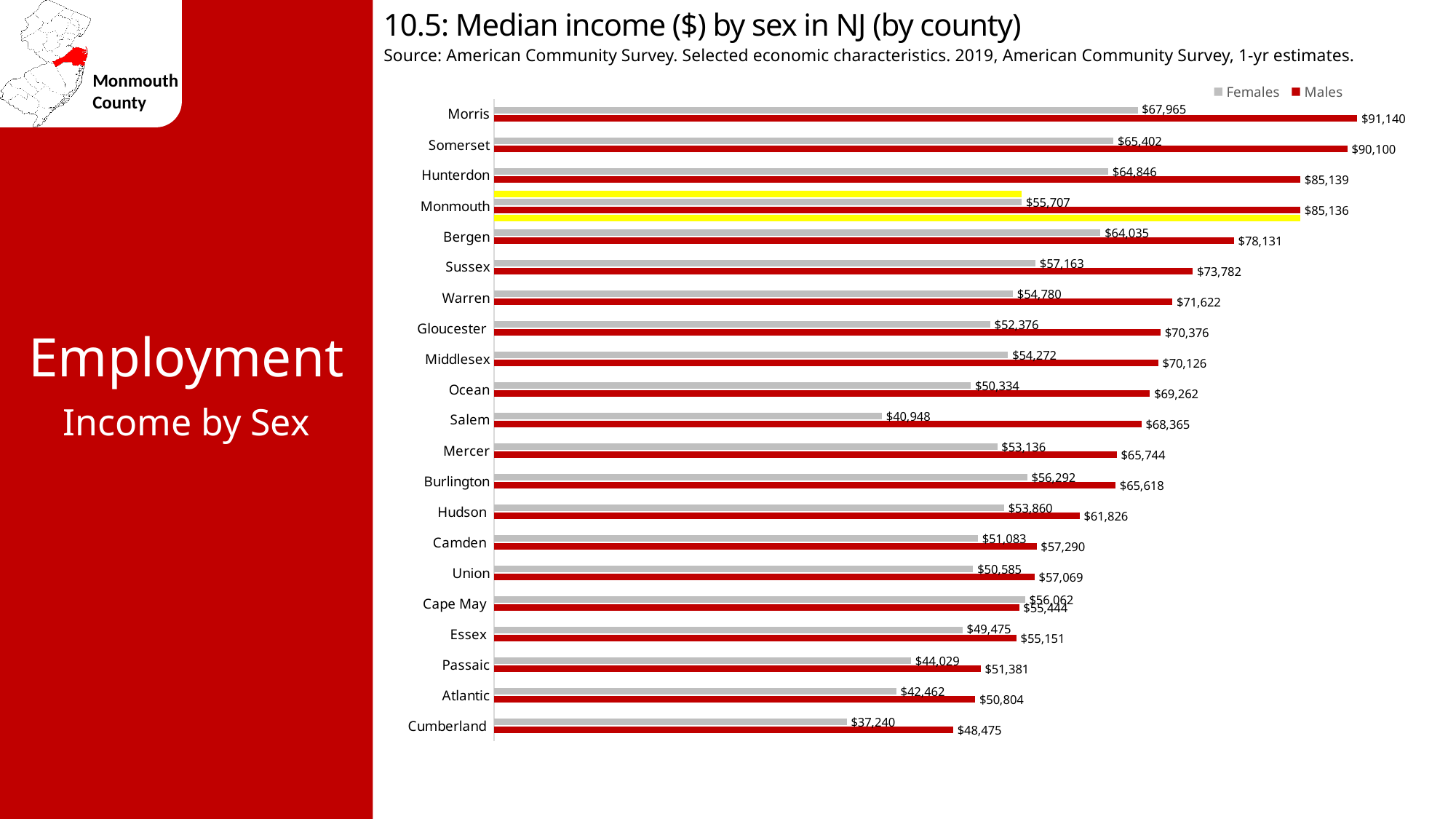
What is the median income for males in Monmouth County? $85,136 What is the median income for females in Salem County? $40,948 What is the difference between the male and female median incomes in Morris County? $23,175 How many counties are shown in the chart? 21 Which county has the lowest median income for females? Cumberland In Cape May County, which is larger: the female median income or the male median income? Female median income What is the median income for females in Morris County? $67,965 Which county has the highest median income for males? Morris What type of chart is shown on the slide? Bar chart What is the difference between the male and female median incomes in Monmouth County? $29,429 Which county has a higher male median income, Bergen or Sussex? Bergen How many series does the legend list? 2